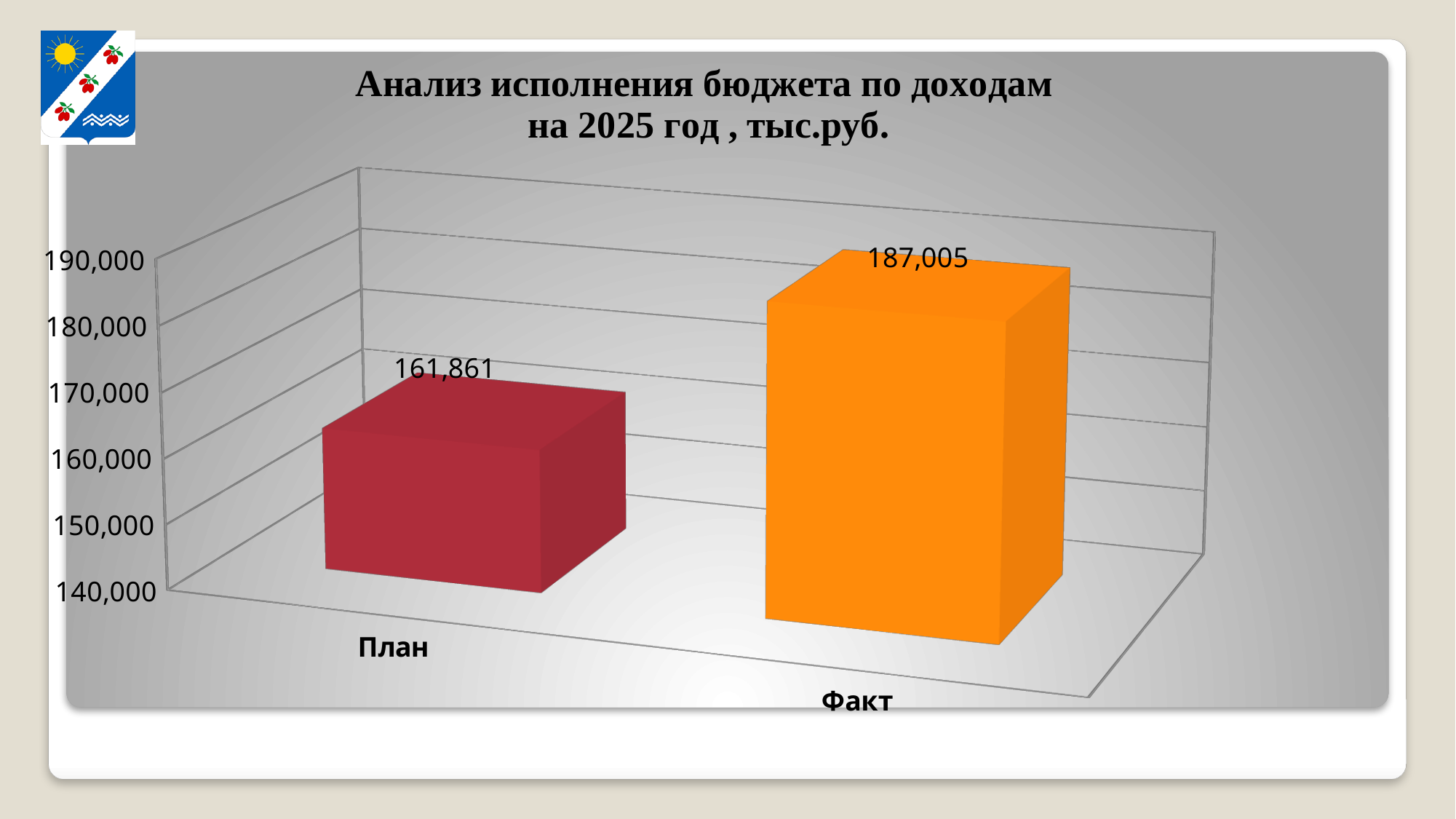
What kind of chart is shown on the slide? bar chart How many categories are shown in the chart? 2 What is the difference between the values for Факт and План? 25,144 Which is larger, the value for План or the value for Факт? Факт What colour is the bar for Факт? orange Which category has the lowest value? План Is the value for План greater or less than 170,000? less Which category has the highest value? Факт What is the value for Факт? 187,005 What is the value for План? 161,861 Is the value for Факт greater or less than 180,000? greater What is the title of the chart? Анализ исполнения бюджета по доходам на 2025 год , тыс.руб.